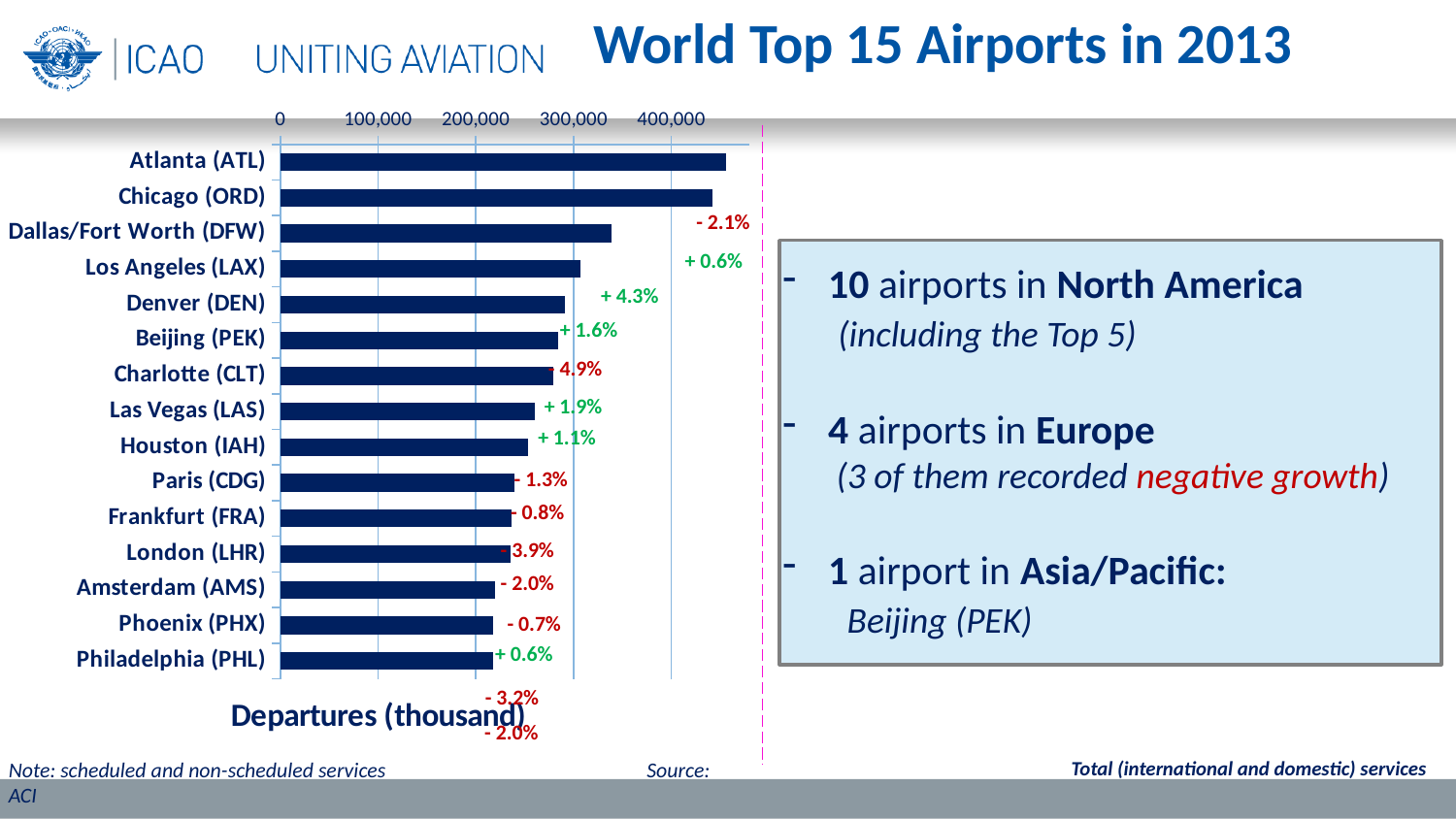
Is the value for Chicago (ORD) greater or less than 400,000? greater Which has more departures, Atlanta (ATL) or Dallas/Fort Worth (DFW)? Atlanta (ATL) Is the value for Dallas/Fort Worth (DFW) greater or less than 300,000? greater Is the value for Paris (CDG) greater or less than 300,000? less Which has more departures, Chicago (ORD) or London (LHR)? Chicago (ORD) What kind of chart is shown on the slide? bar chart How many airports are listed in the chart? 15 Which airport has the highest number of departures in the chart? Atlanta (ATL) What is the axis title shown below the bars? Departures (thousand) Do the bar values rise or fall going down the list from Atlanta (ATL) to Philadelphia (PHL)? fall